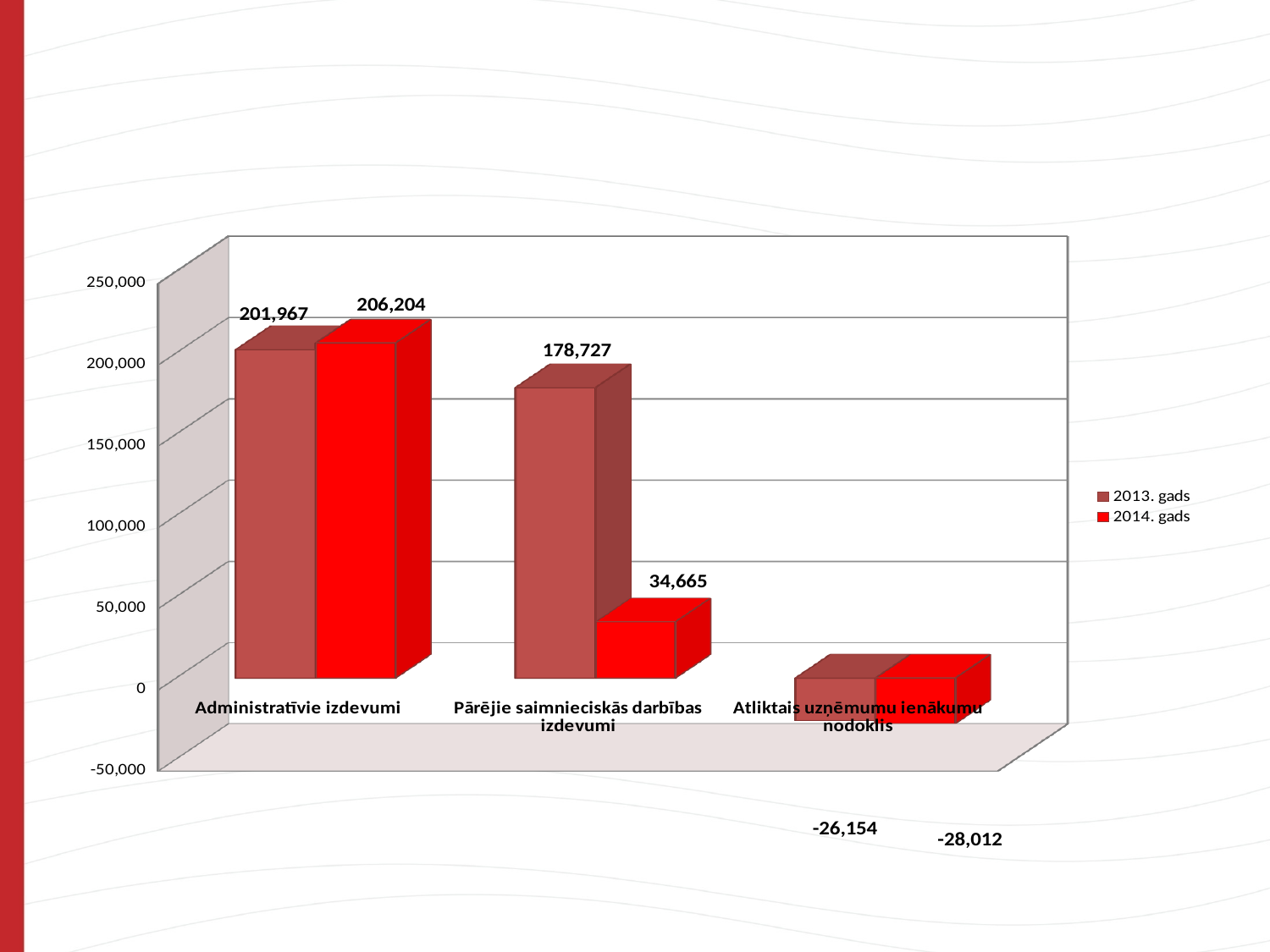
What is the value for Pārējie saimnieciskās darbības izdevumi in the 2014. gads series? 34,665 What kind of chart is shown on the slide? Bar chart What is the value for Atliktais uzņēmumu ienākumu nodoklis in the 2013. gads series? -26,154 What is the difference between the 2013. gads and 2014. gads values for Pārējie saimnieciskās darbības izdevumi? 144,062 What is the value for Administratīvie izdevumi in the 2013. gads series? 201,967 Which is larger for Administratīvie izdevumi: the 2013. gads value or the 2014. gads value? 2014. gads Which category has the highest value in the 2013. gads series? Administratīvie izdevumi How many series does the legend list? 2 How many categories are shown on the x axis? 3 What is the value for Administratīvie izdevumi in the 2014. gads series? 206,204 Which category has the lowest value in the 2014. gads series? Atliktais uzņēmumu ienākumu nodoklis What are the two series names listed in the legend? 2013. gads and 2014. gads